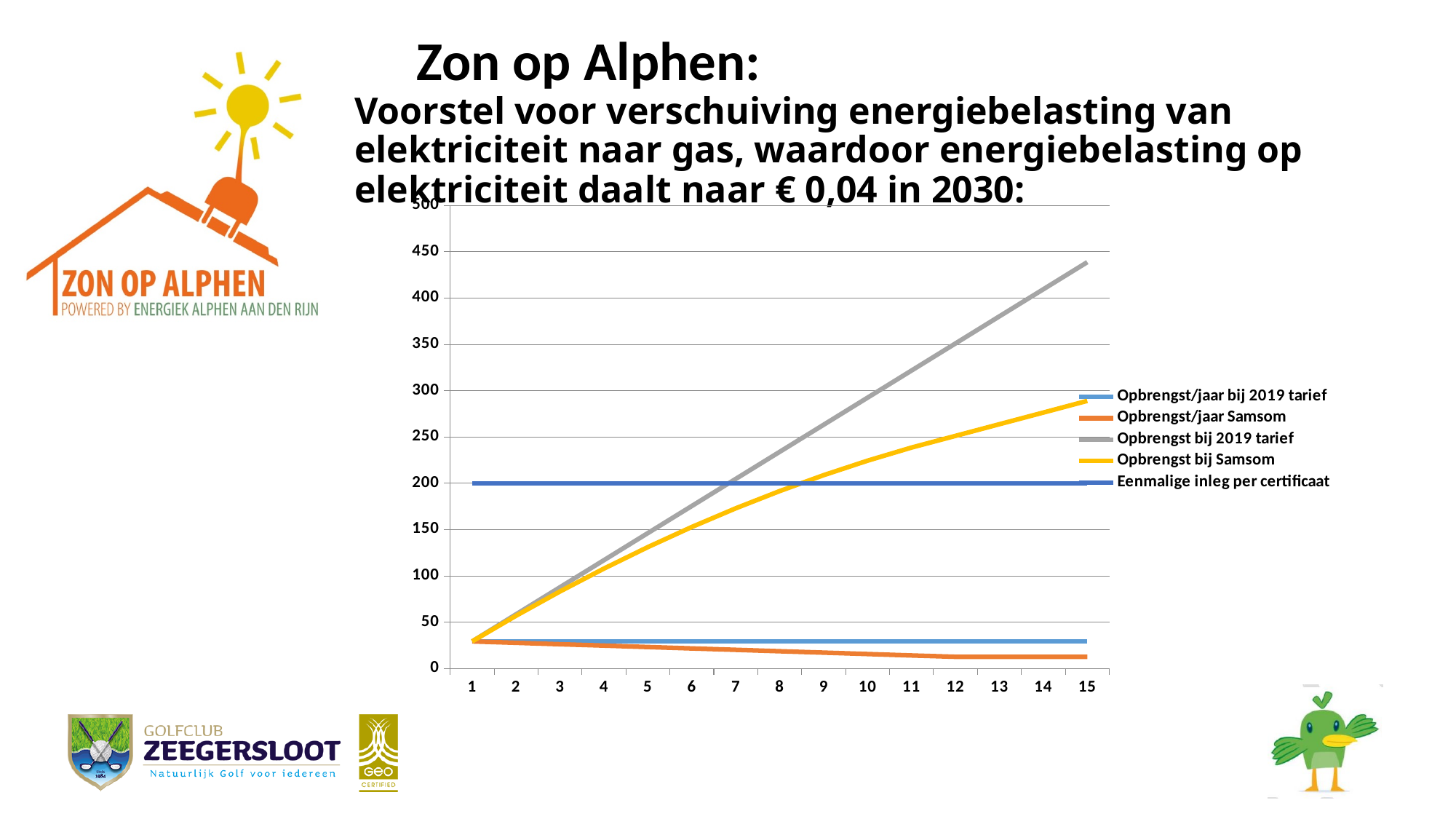
What kind of chart is shown on the slide? line chart Does the 'Opbrengst/jaar Samsom' line rise or fall from 1 to 15? fall Does the 'Opbrengst bij 2019 tarief' line rise or fall from 1 to 15? rise Which series is drawn in yellow? Opbrengst bij Samsom How many points are there along the x axis of the chart? 15 Is the value of 'Opbrengst bij Samsom' at point 15 greater or less than 300? less Is the value of 'Opbrengst bij 2019 tarief' at point 15 greater or less than 400? greater At point 15, which is larger: 'Opbrengst bij 2019 tarief' or 'Opbrengst bij Samsom'? Opbrengst bij 2019 tarief What is the value of the 'Eenmalige inleg per certificaat' line? 200 Is the value of 'Opbrengst/jaar Samsom' at point 15 greater or less than 50? less Which series reaches the highest value at point 15? Opbrengst bij 2019 tarief How many series does the chart legend list? 5